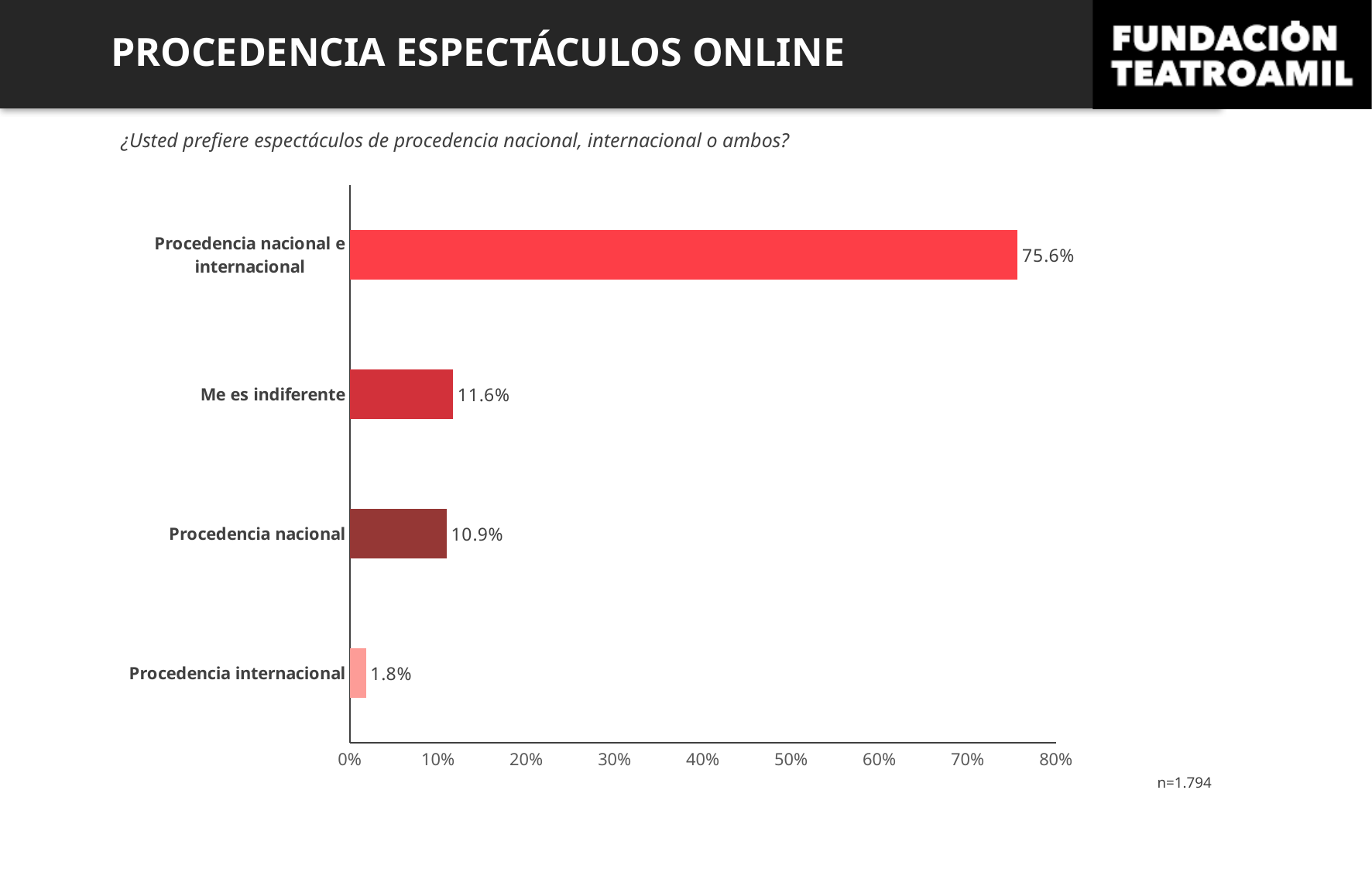
Which category has the highest value? Procedencia nacional e internacional Which category has the lowest value? Procedencia internacional What is the value for "Me es indiferente"? 11.6% What is the value for "Procedencia nacional"? 10.9% Is the value for "Procedencia nacional e internacional" greater or less than 70%? greater What is the value for "Procedencia nacional e internacional"? 75.6% What is the difference between the values for "Procedencia nacional e internacional" and "Me es indiferente"? 64.0% How many categories are shown in the chart? 4 What kind of chart is shown on the slide? bar chart Which is larger, the value for "Me es indiferente" or the value for "Procedencia nacional"? Me es indiferente What is the value for "Procedencia internacional"? 1.8% What is the difference between the values for "Procedencia nacional" and "Procedencia internacional"? 9.1%